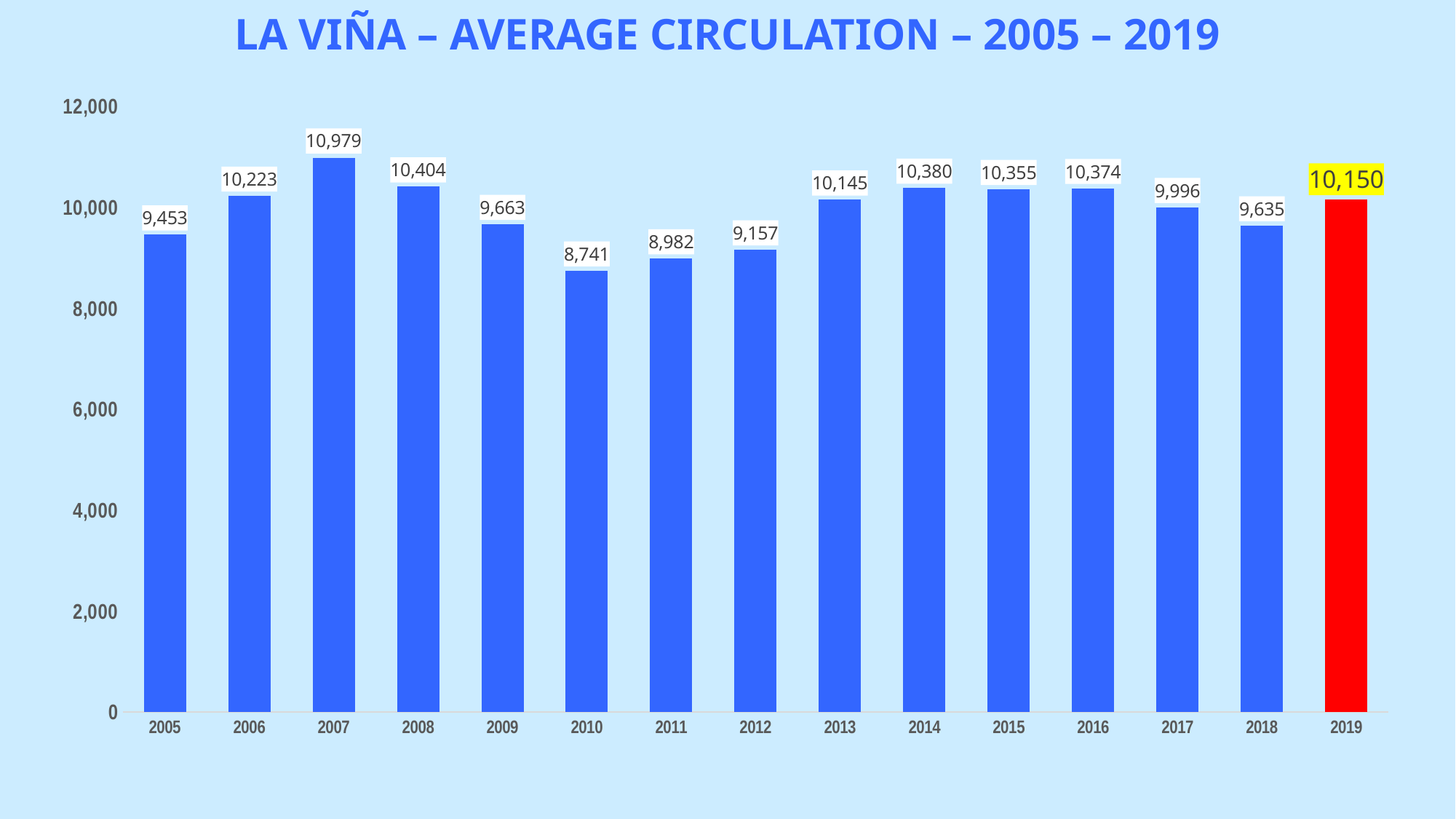
What kind of chart is shown on the slide? bar chart What is the difference between the average circulation in 2007 and in 2010? 2,238 Which year had a higher average circulation, 2014 or 2016? 2014 Is the average circulation for 2017 greater or less than 10,000? less Which year had the highest average circulation? 2007 Which year had the lowest average circulation? 2010 What was the average circulation in 2010? 8,741 What was the average circulation in 2019? 10,150 What was the average circulation in 2007? 10,979 How many years are shown on the chart? 15 Did the average circulation rise or fall from 2007 to 2010? fall Which year's bar is coloured red instead of blue? 2019